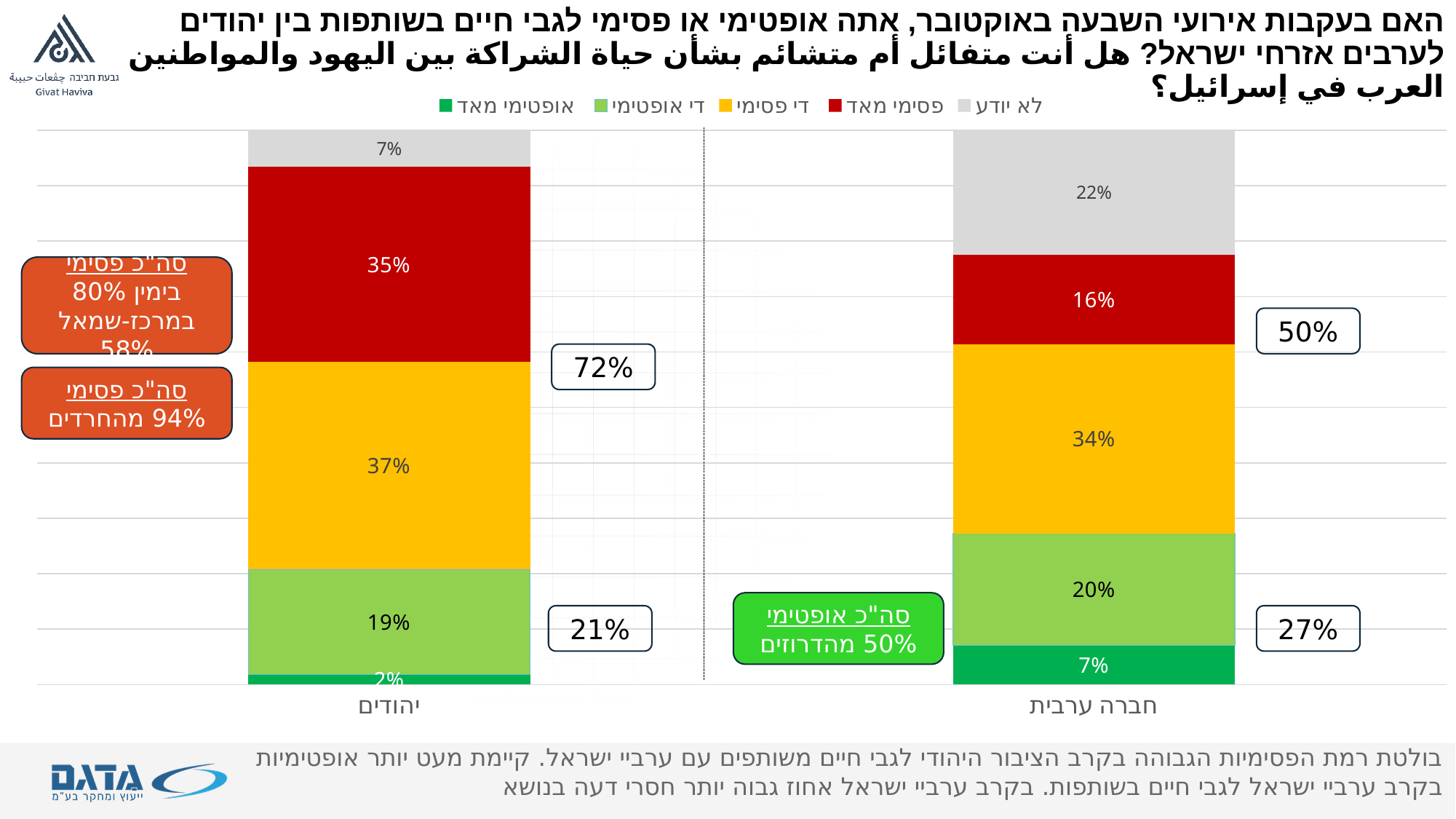
Which colour represents 'לא יודע' in the legend? grey What is the value of the 'אופטימי מאד' segment for 'יהודים'? 2% What is the value of the 'לא יודע' segment for 'חברה ערבית'? 22% Which segment is the largest in the 'חברה ערבית' bar? די פסימי What is the difference between the 'לא יודע' values for 'חברה ערבית' and 'יהודים'? 15% Which category has the larger 'פסימי מאד' segment, 'יהודים' or 'חברה ערבית'? יהודים What is the difference between the 'די פסימי' values for 'יהודים' and 'חברה ערבית'? 3% What kind of chart is shown on the slide? stacked bar chart How many categories (bars) does the chart show? 2 How many series does the legend list? 5 What is the value of the 'פסימי מאד' segment for 'יהודים'? 35% What is the value of the 'די אופטימי' segment for 'חברה ערבית'? 20%